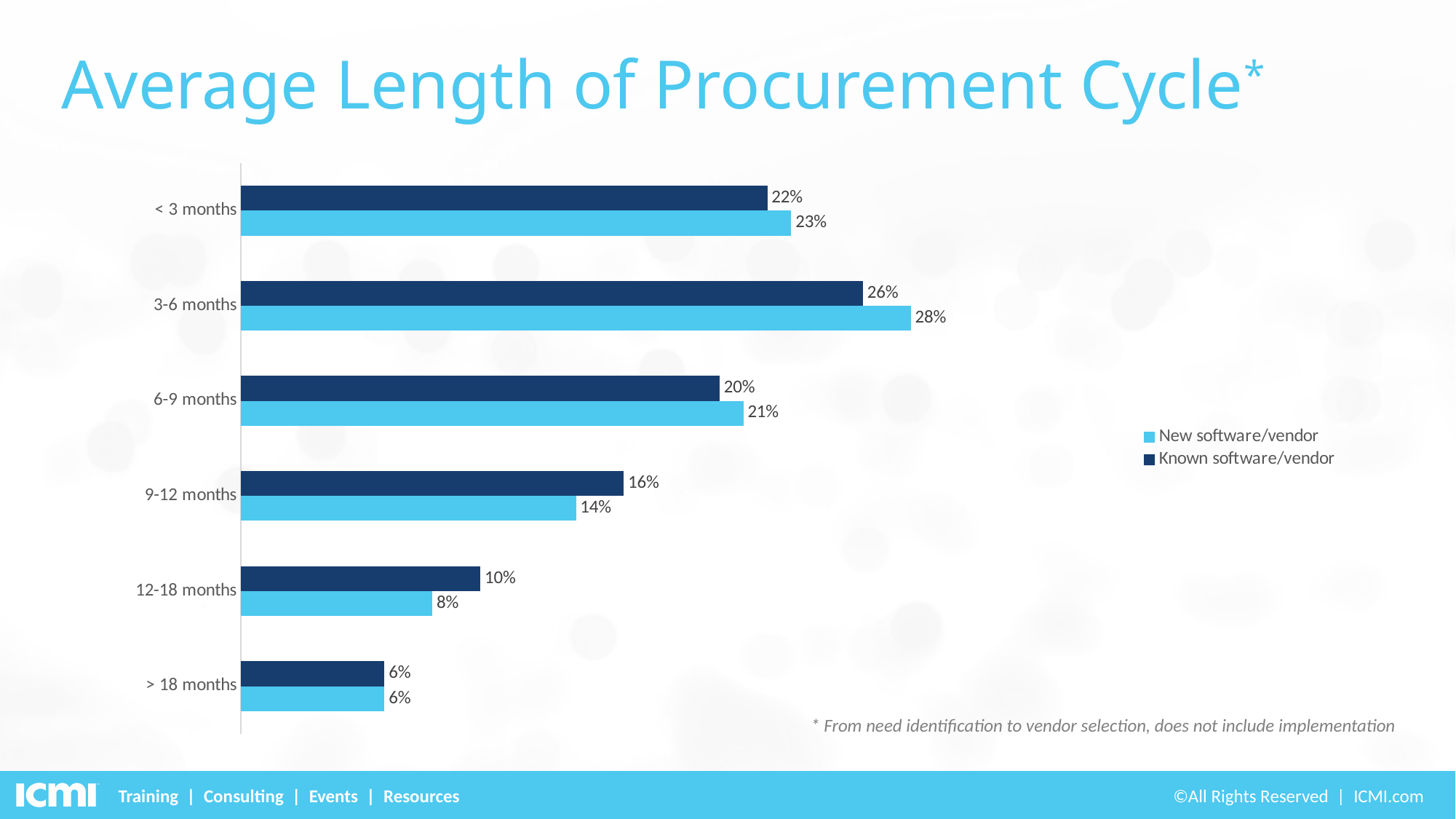
What is the difference between the New software/vendor and Known software/vendor values in the 12-18 months category? 2% Which category has the lowest value for Known software/vendor? > 18 months Which category has the highest value for New software/vendor? 3-6 months Which colour represents the Known software/vendor series? Dark blue What is the value for New software/vendor in the 3-6 months category? 28% How many categories are shown on the chart? 6 In the 9-12 months category, which series has the larger value, New software/vendor or Known software/vendor? Known software/vendor What kind of chart is shown on the slide? Bar chart What is the title of the chart on the slide? Average Length of Procurement Cycle* What is the value for Known software/vendor in the < 3 months category? 22% What is the value for Known software/vendor in the 9-12 months category? 16% How many series does the legend list? 2